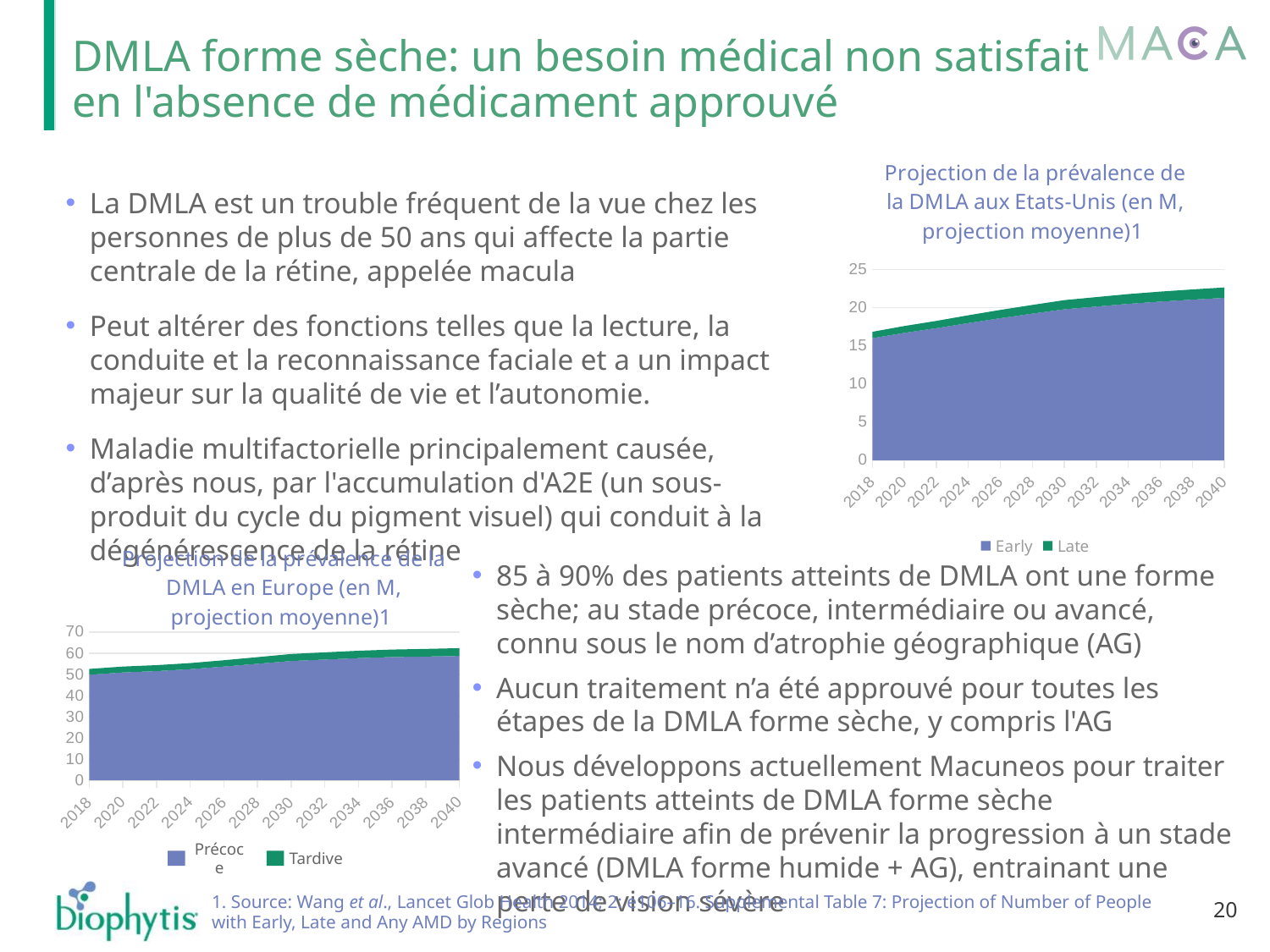
In the 'Projection de la prévalence de la DMLA en Europe' chart, is the total value for 2040 greater or less than 70? less In the 'Projection de la prévalence de la DMLA aux Etats-Unis' chart, does the total prevalence rise or fall from 2018 to 2040? Rise What kind of chart is the 'Projection de la prévalence de la DMLA aux Etats-Unis' chart? Stacked area chart In the 'Projection de la prévalence de la DMLA aux Etats-Unis' chart, is the total value for 2040 greater or less than 20? greater What are the two legend entries of the 'Projection de la prévalence de la DMLA en Europe' chart? Précoce and Tardive What are the two legend entries of the 'Projection de la prévalence de la DMLA aux Etats-Unis' chart? Early and Late In the 'Projection de la prévalence de la DMLA aux Etats-Unis' chart, is the total value for 2018 greater or less than 20? less How many year labels are shown on the x axis of the 'Projection de la prévalence de la DMLA en Europe' chart? 12 How many series does the legend of the 'Projection de la prévalence de la DMLA aux Etats-Unis' chart list? 2 In the 'Projection de la prévalence de la DMLA en Europe' chart, does the total prevalence rise or fall from 2018 to 2040? Rise In the 'Projection de la prévalence de la DMLA aux Etats-Unis' chart, which series is larger, Early or Late? Early